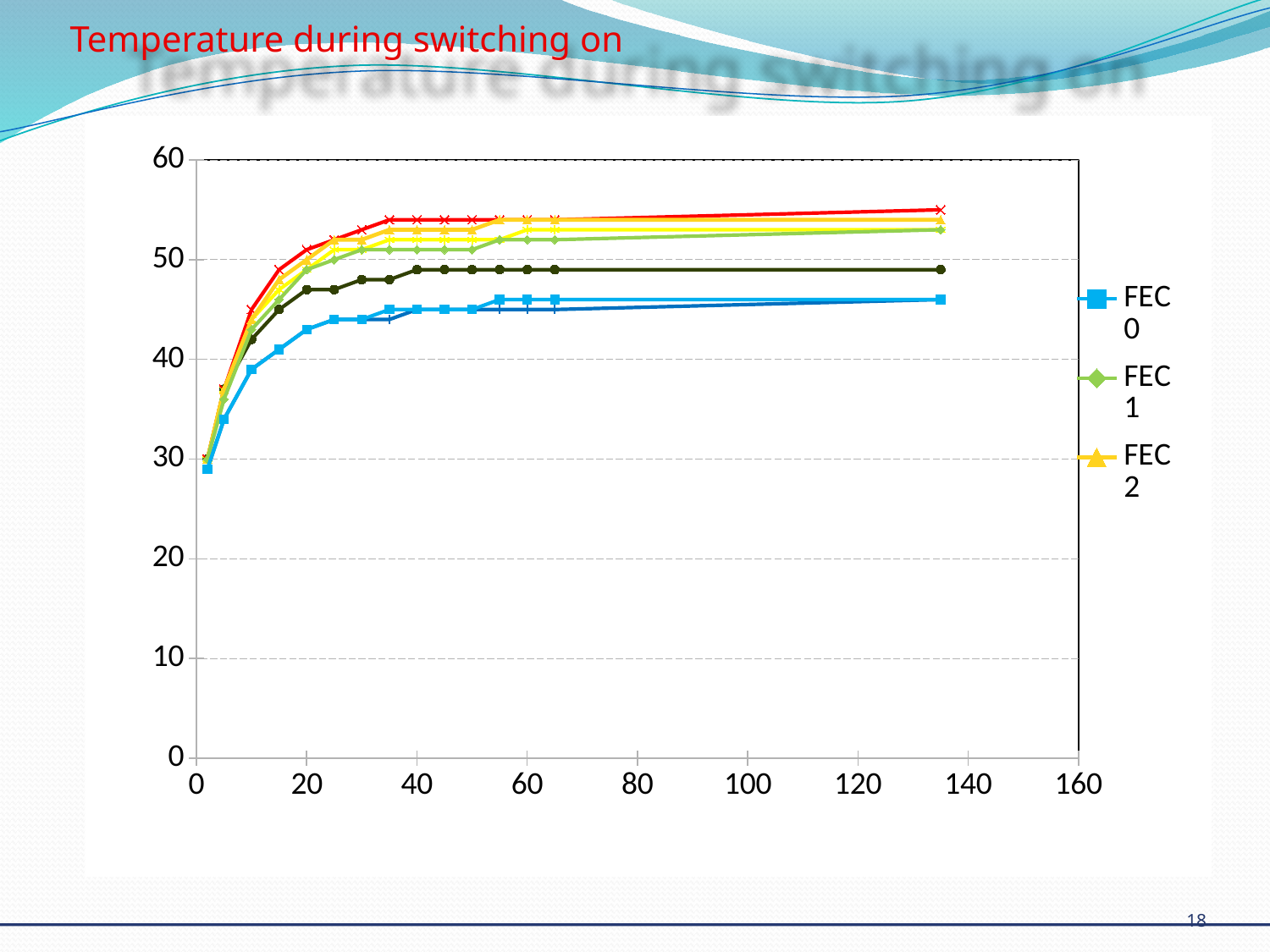
Is the value for FEC 0 at x = 135 greater or less than 40? greater Is the value for FEC 2 at x = 135 greater or less than 50? greater Is the value for FEC 0 at x = 5 greater or less than 40? less What is the title of the chart? Temperature during switching on How many series does the visible legend list? 3 At x = 135, which series has the higher value, FEC 0 or FEC 2? FEC 2 What kind of chart is shown on the slide? line chart What colour is the marker for FEC 0 in the legend? blue What is the highest value labelled on the y axis? 60 Do the values for FEC 0 rise or fall as the x axis increases? rise